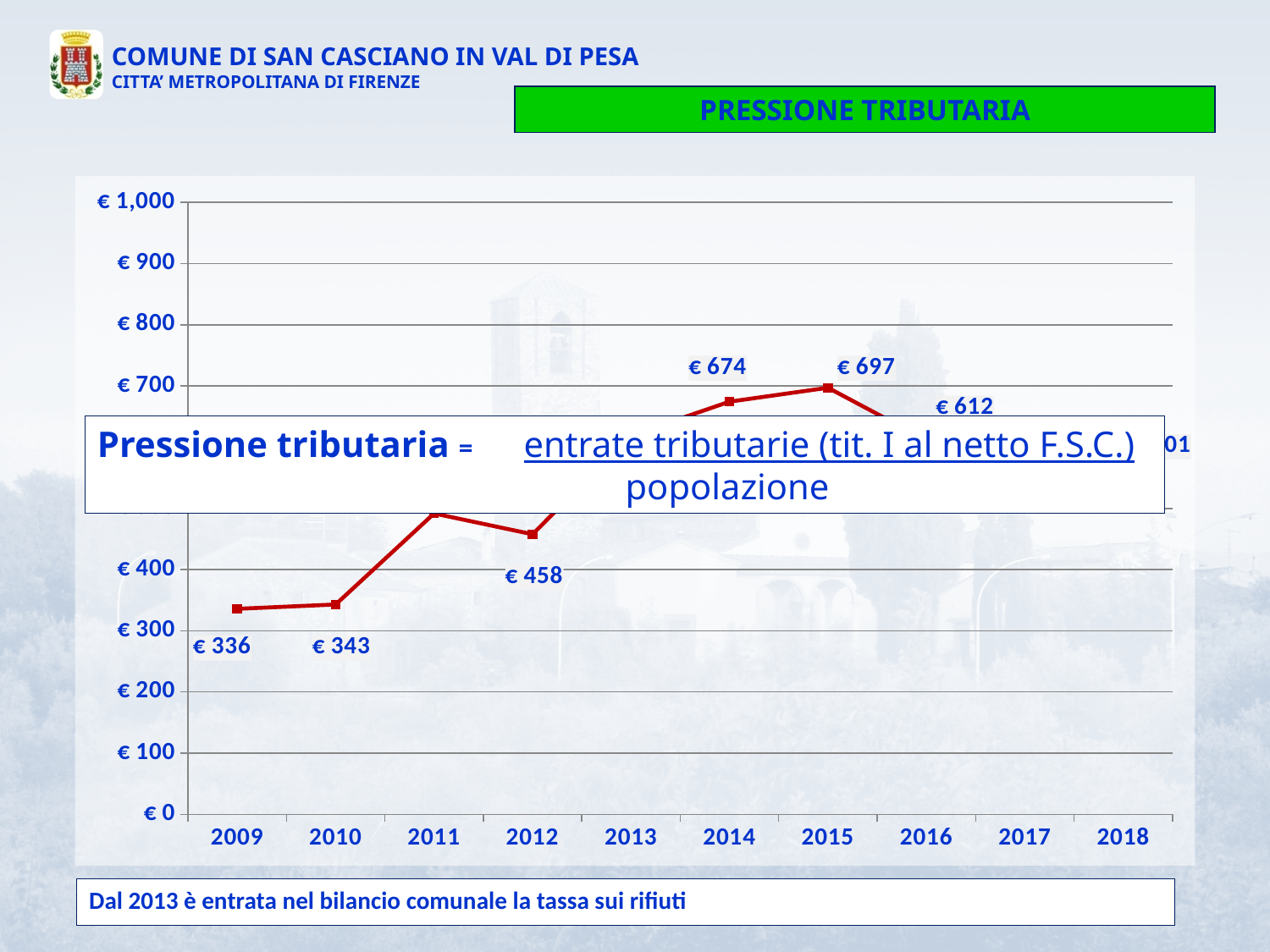
How many years are shown on the x axis? 10 What is the value for 2014? € 674 What is the value for 2009? € 336 What is the value for 2016? € 612 What is the value for 2012? € 458 What is the title of the chart? PRESSIONE TRIBUTARIA What kind of chart is shown on the slide? line chart What is the value for 2010? € 343 Is the value for 2011 greater or less than € 400? greater What is the value for 2015? € 697 Which year has the higher value, 2014 or 2016? 2014 What is the difference between the values for 2015 and 2014? € 23